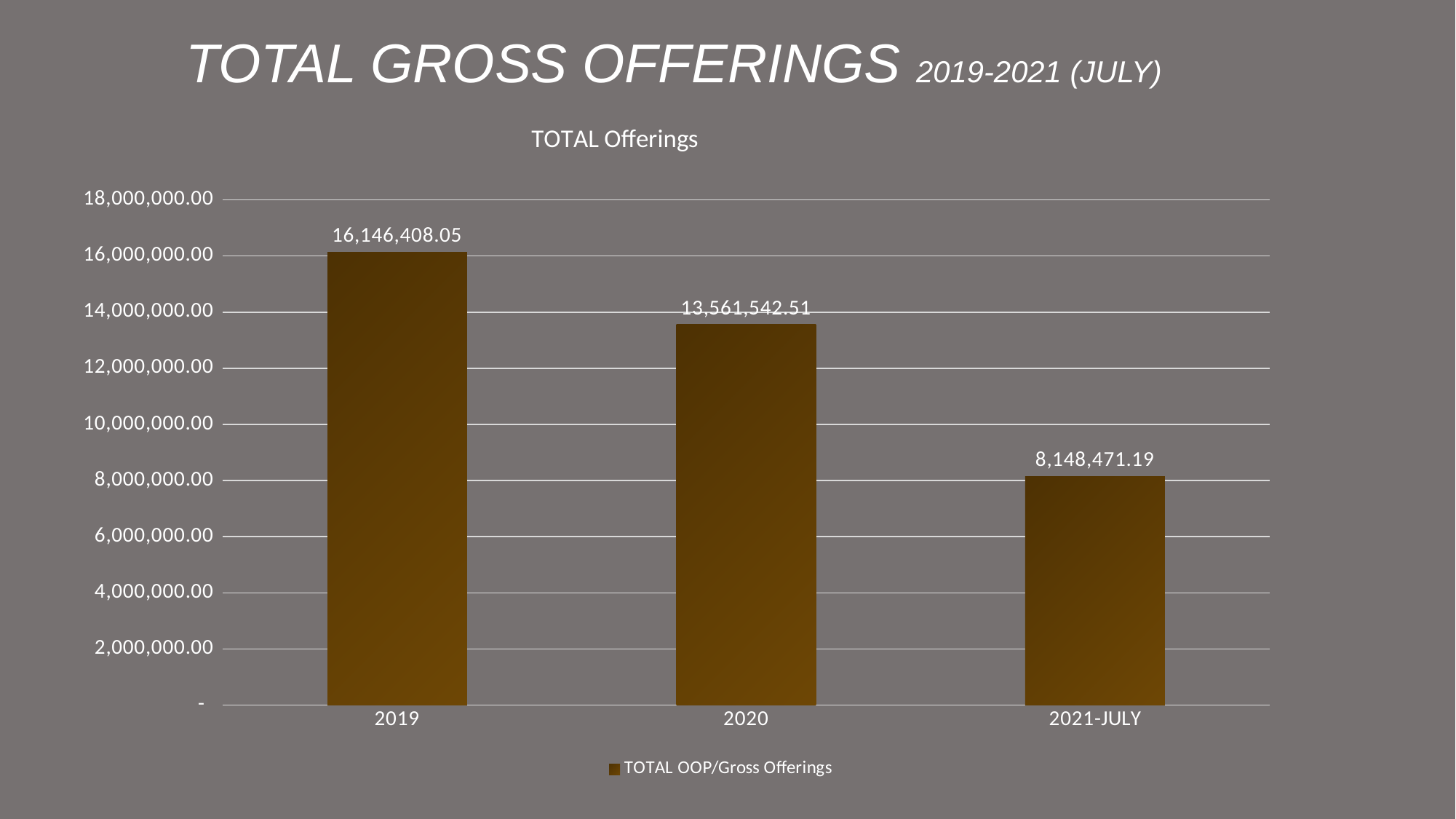
What is the value for 2020? 13,561,542.51 How many categories are shown on the x axis? 3 What is the value for 2019? 16,146,408.05 Which category has the lowest value? 2021-JULY Is the value for 2020 greater or less than 14,000,000.00? less Which category has the highest value? 2019 What kind of chart is shown? bar chart Which is larger, the value for 2020 or the value for 2021-JULY? 2020 What is the difference between the values for 2019 and 2020? 2,584,865.54 Do the values rise or fall from 2019 to 2021-JULY? fall What is the value for 2021-JULY? 8,148,471.19 What is the difference between the values for 2020 and 2021-JULY? 5,413,071.32